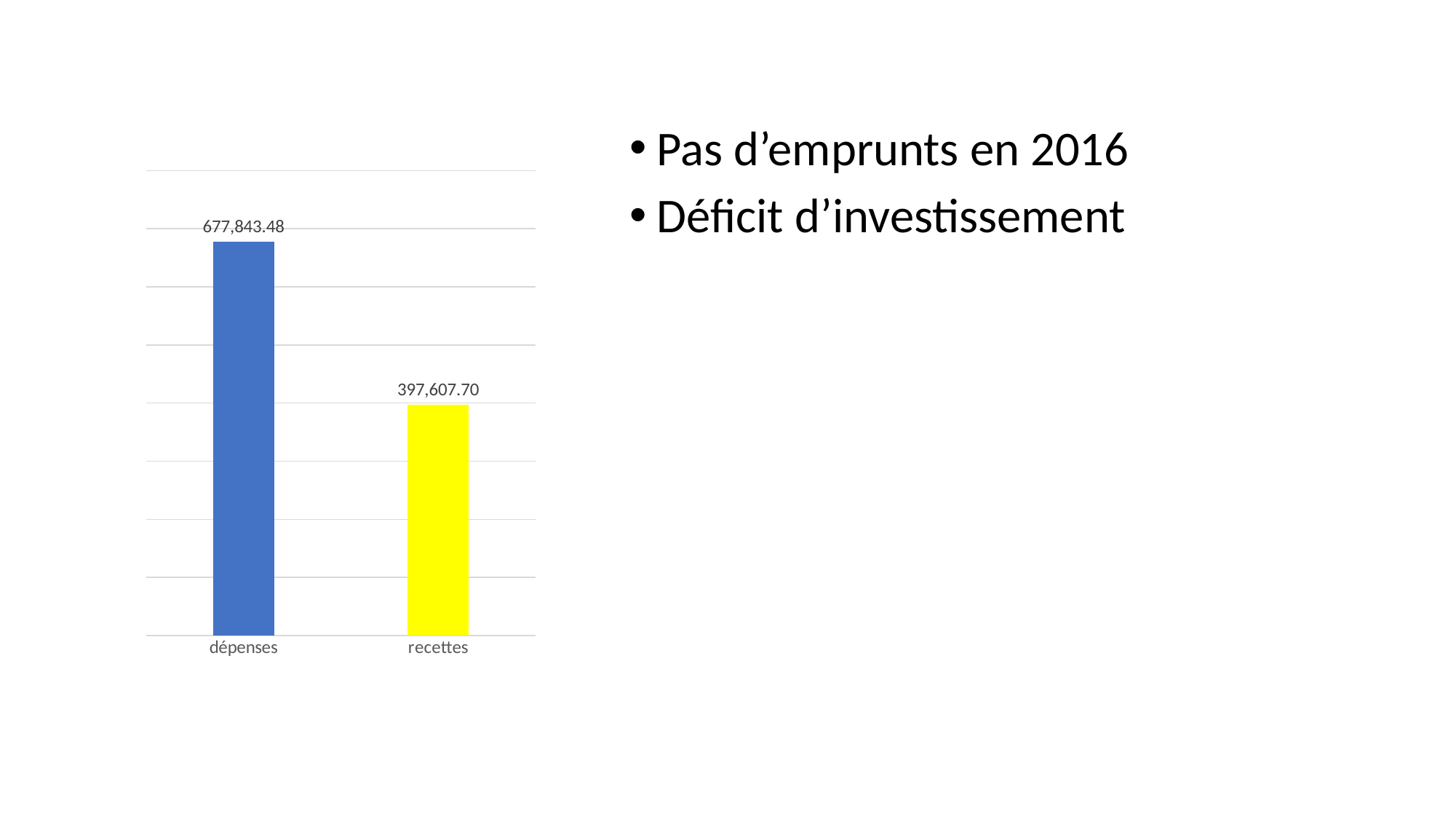
What colour is the bar for recettes? yellow Which is larger, dépenses or recettes? dépenses Which category has the highest value? dépenses What is the value for dépenses? 677,843.48 What colour is the bar for dépenses? blue Which category has the lowest value? recettes What is the difference between the values for dépenses and recettes? 280,235.78 What is the value for recettes? 397,607.70 How many categories are shown in the chart? 2 What kind of chart is shown on the slide? bar chart